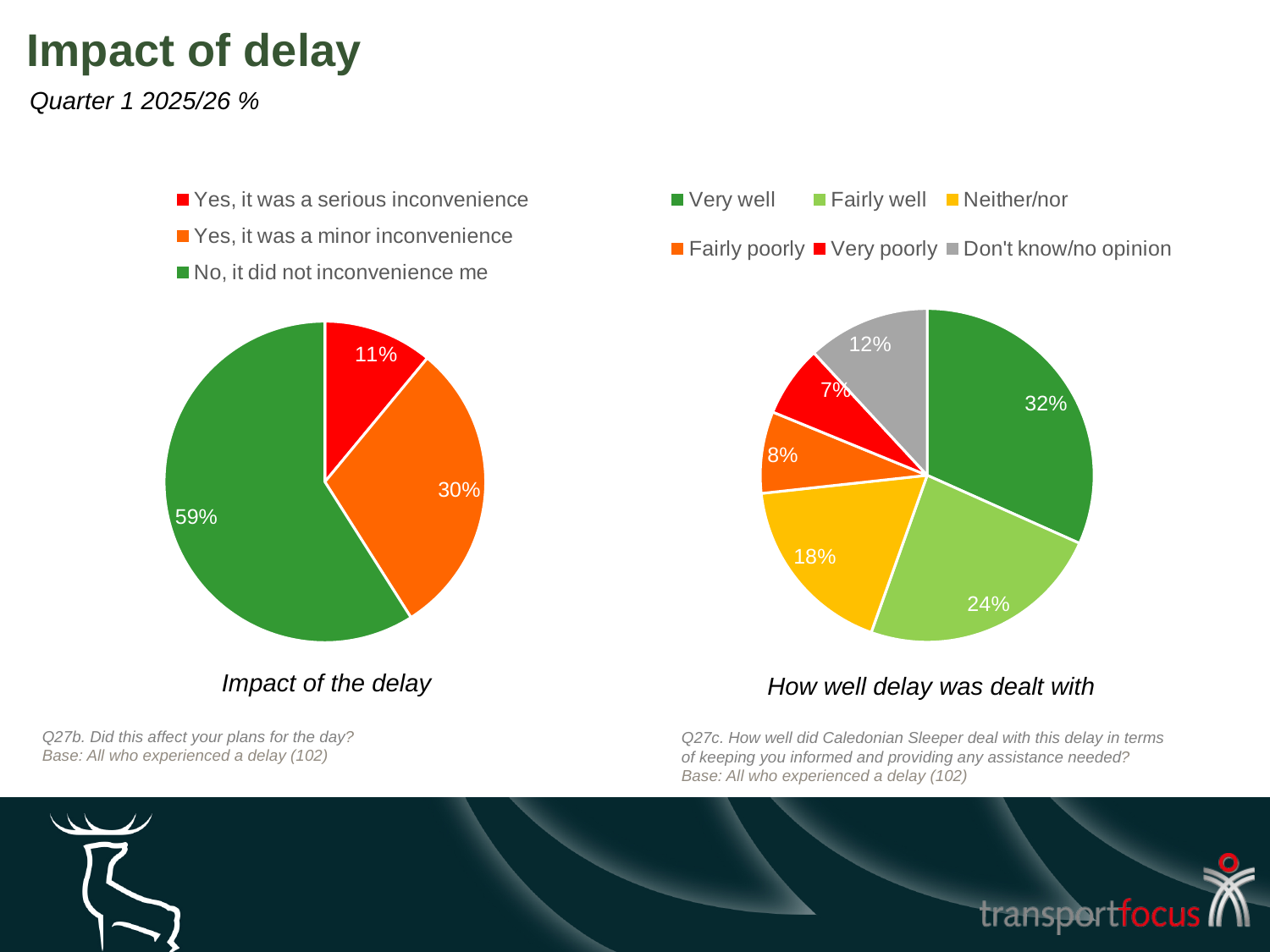
In the 'How well delay was dealt with' pie chart, what percentage said 'Neither/nor'? 18% In the 'How well delay was dealt with' pie chart, which is larger: 'Fairly well' or 'Don't know/no opinion'? Fairly well In the 'Impact of the delay' pie chart, what percentage said 'No, it did not inconvenience me'? 59% In the 'How well delay was dealt with' pie chart, what percentage said 'Very well'? 32% What colour represents 'Don't know/no opinion' in the 'How well delay was dealt with' chart? Grey In the 'How well delay was dealt with' pie chart, what is the combined share of 'Very well' and 'Fairly well'? 56% In the 'How well delay was dealt with' pie chart, which category has the smallest share? Very poorly What type of chart is used for 'Impact of the delay'? Pie chart In the 'Impact of the delay' pie chart, what is the difference between 'Yes, it was a minor inconvenience' and 'Yes, it was a serious inconvenience'? 19 percentage points In the 'Impact of the delay' pie chart, which category has the largest share? No, it did not inconvenience me How many categories does the legend of the 'How well delay was dealt with' chart list? 6 In the 'Impact of the delay' pie chart, what percentage said 'Yes, it was a serious inconvenience'? 11%